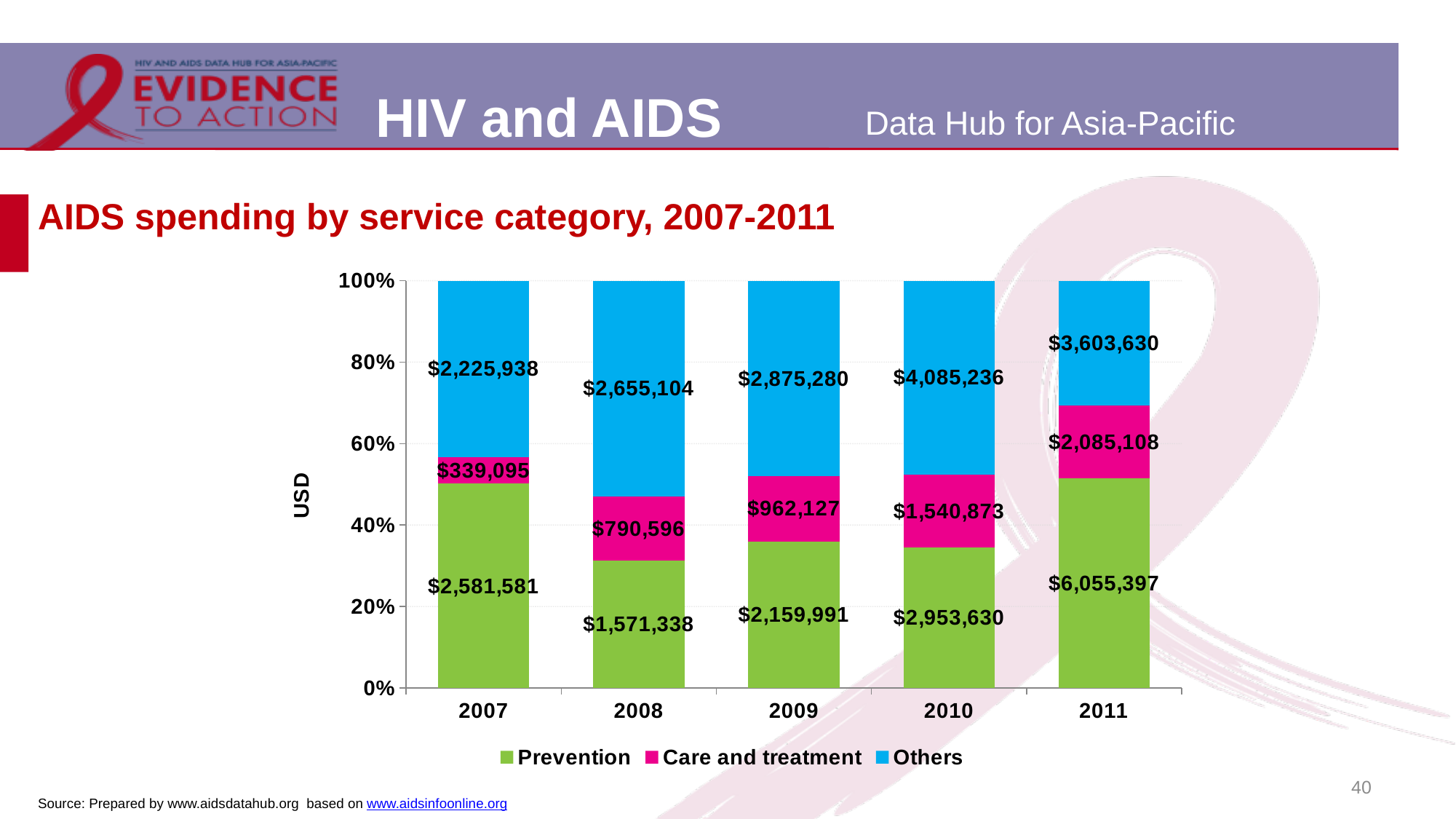
How many series does the legend list? 3 In which year is the Prevention spending value the highest? 2011 What is the Care and treatment spending value shown for 2008? $790,596 What is the difference between the Others spending in 2010 and in 2009? $1,209,956 Which is larger, the Prevention spending in 2007 or in 2008? 2007 In which year is the Care and treatment spending value the lowest? 2007 What kind of chart is shown on the slide? Stacked bar chart Is the Prevention share of the 2008 bar greater or less than 40%? less What is the Others spending value shown for 2010? $4,085,236 How many years are shown on the x axis? 5 Do the Care and treatment spending values rise or fall from 2007 to 2011? Rise What is the Prevention spending value shown for 2011? $6,055,397